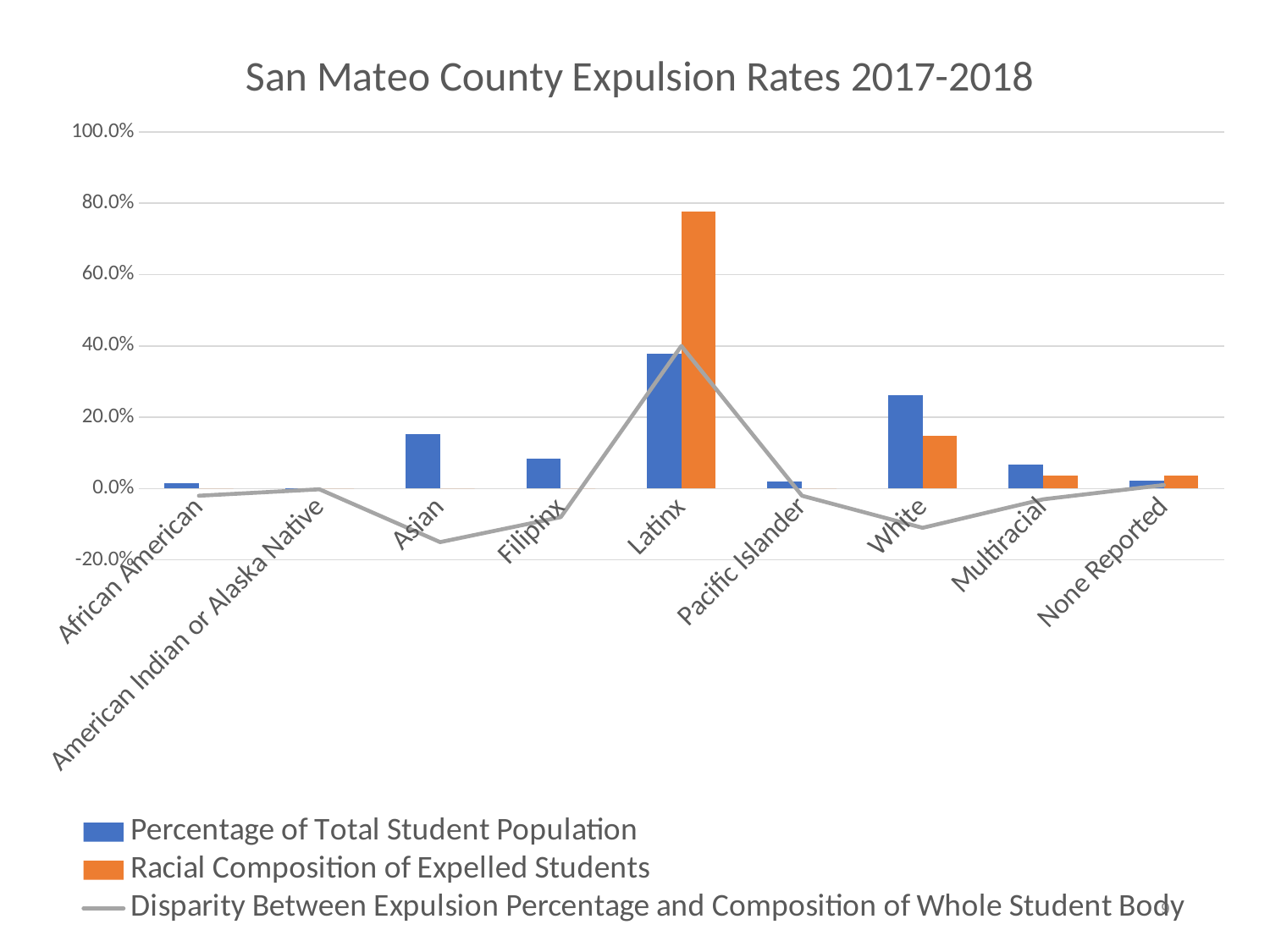
Which category has the highest value for Racial Composition of Expelled Students? Latinx How many racial/ethnic categories are shown on the x axis? 9 For White, which is larger: Percentage of Total Student Population or Racial Composition of Expelled Students? Percentage of Total Student Population Is the Racial Composition of Expelled Students value for Latinx greater or less than 60.0%? greater Is the Percentage of Total Student Population value for Asian greater or less than 20.0%? less Which category has the lowest point on the Disparity line? Asian What kind of chart is shown on the slide? A combined bar and line chart Is the Disparity line value for Asian greater or less than 0.0%? less Which category has the highest value for Percentage of Total Student Population? Latinx What is the title of the chart? San Mateo County Expulsion Rates 2017-2018 How many series does the legend list? 3